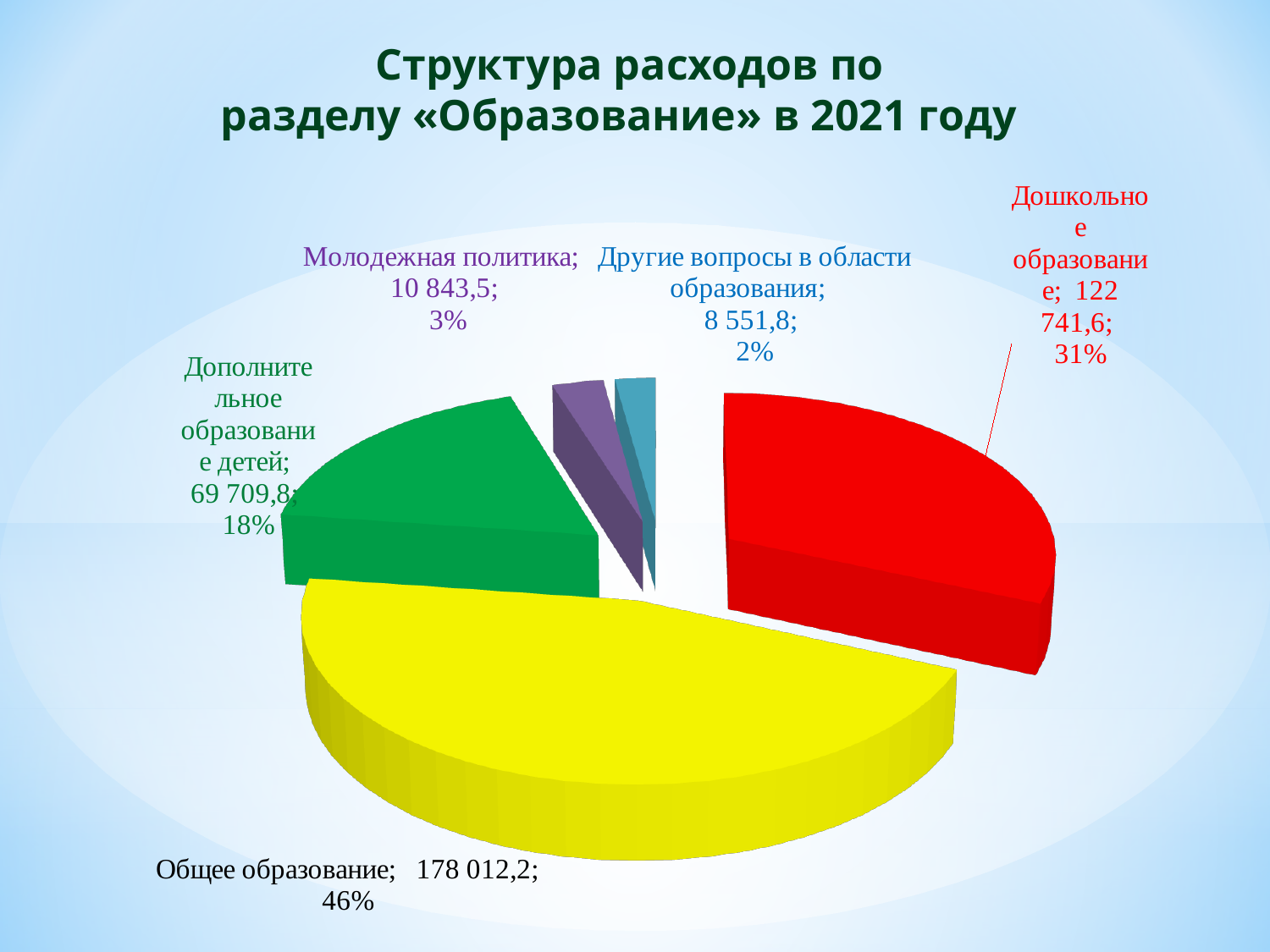
What is the value for Дошкольное образование? 122 741,6 What kind of chart is shown on the slide? Pie chart What is the value for Молодежная политика? 10 843,5 What is the value for Дополнительное образование детей? 69 709,8 What is the value for Общее образование? 178 012,2 Which is larger, the value for Молодежная политика or the value for Другие вопросы в области образования? Молодежная политика Which category has the smallest slice? Другие вопросы в области образования How many slices does the pie chart have? 5 Which category has the largest slice? Общее образование What share of the pie does Другие вопросы в области образования take? 2% What is the difference between the values for Общее образование and Дошкольное образование? 55 270,6 What share of the pie does Общее образование take? 46%